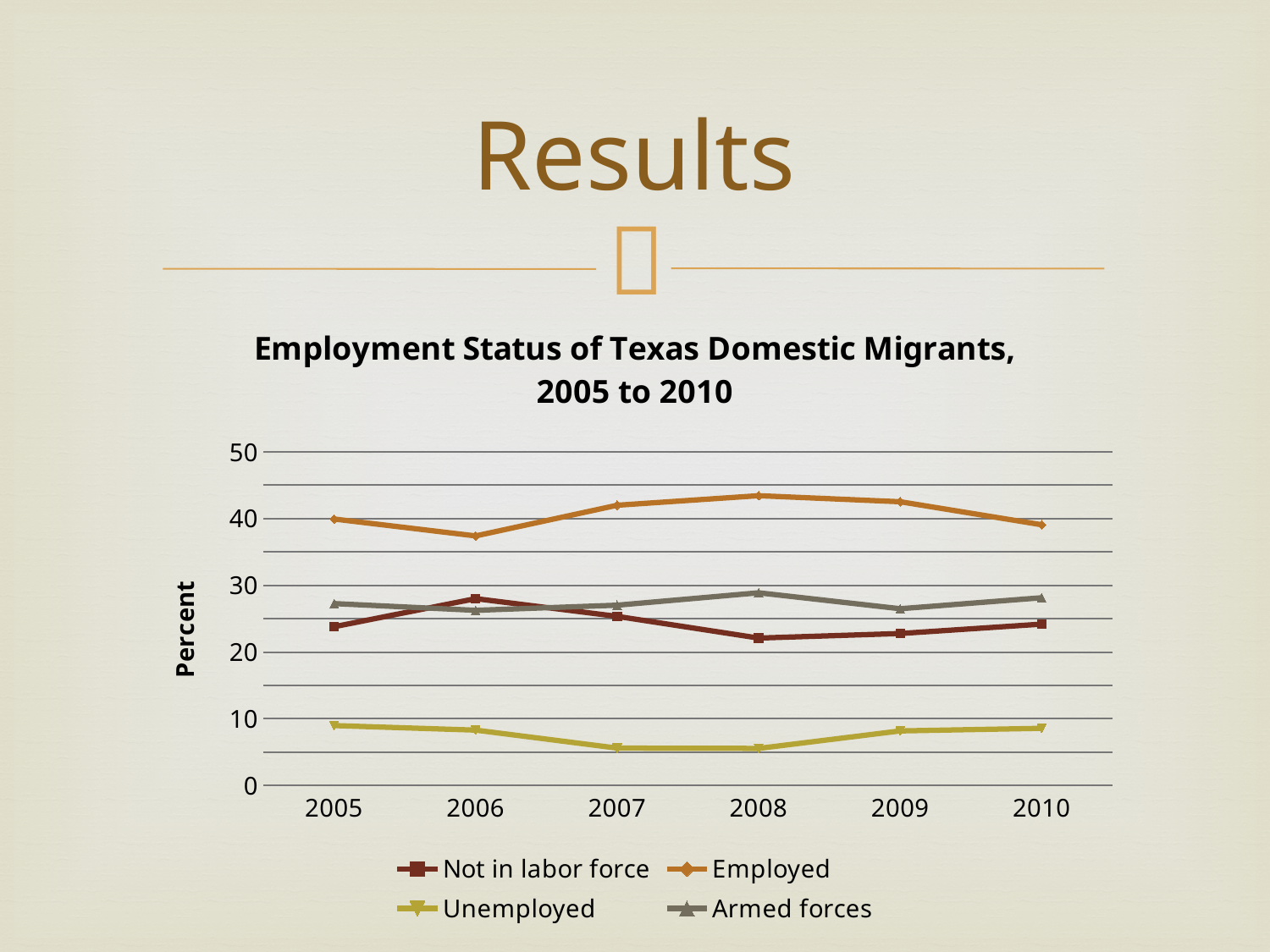
Which series has the highest values across all years? Employed Is the value for Employed in 2008 greater or less than 40? greater How many series does the legend list? 4 Which series has the lowest values across all years? Unemployed What kind of chart is shown on the slide? line chart Is the value for Not in labor force in 2006 greater or less than 30? less In which year does the Employed series reach its highest value? 2008 In which year does the Employed series reach its lowest value? 2006 In 2008, which is larger: Armed forces or Not in labor force? Armed forces How many years are plotted along the x axis? 6 Is the value for Unemployed in 2007 greater or less than 10? less What is the label on the vertical axis? Percent